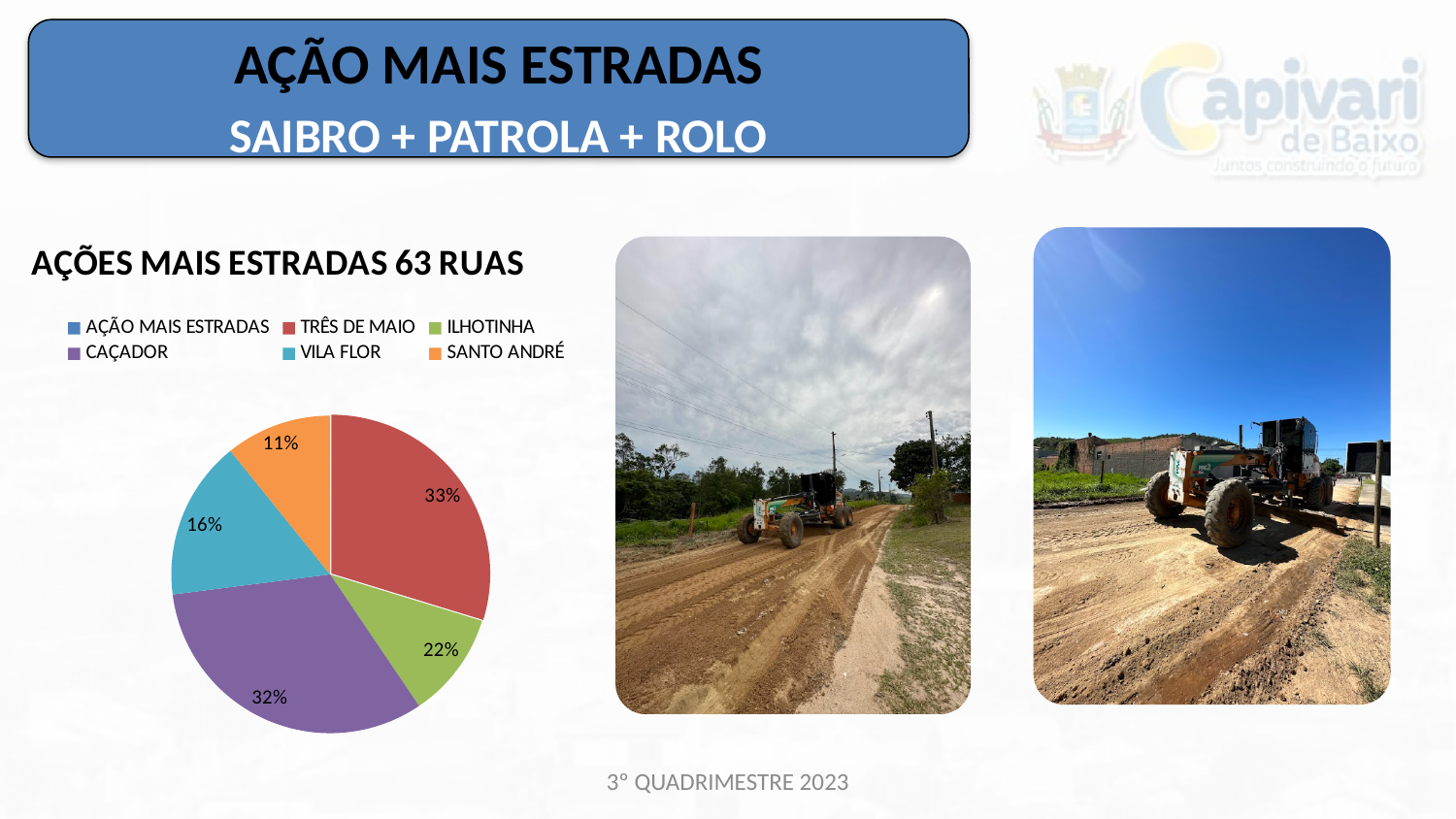
Which slice of the pie chart has the largest percentage? TRÊS DE MAIO What percentage is shown for the ILHOTINHA slice of the pie chart? 22% What kind of chart is shown on the slide? Pie chart How many entries does the legend of the pie chart list? 6 What colour is the CAÇADOR slice in the pie chart? Purple What percentage is shown for the SANTO ANDRÉ slice of the pie chart? 11% What percentage is shown for the TRÊS DE MAIO slice of the pie chart? 33% What percentage is shown for the CAÇADOR slice of the pie chart? 32% Which slice of the pie chart has the smallest percentage? SANTO ANDRÉ What is the difference in percentage points between the ILHOTINHA slice and the VILA FLOR slice? 6 What percentage is shown for the VILA FLOR slice of the pie chart? 16%